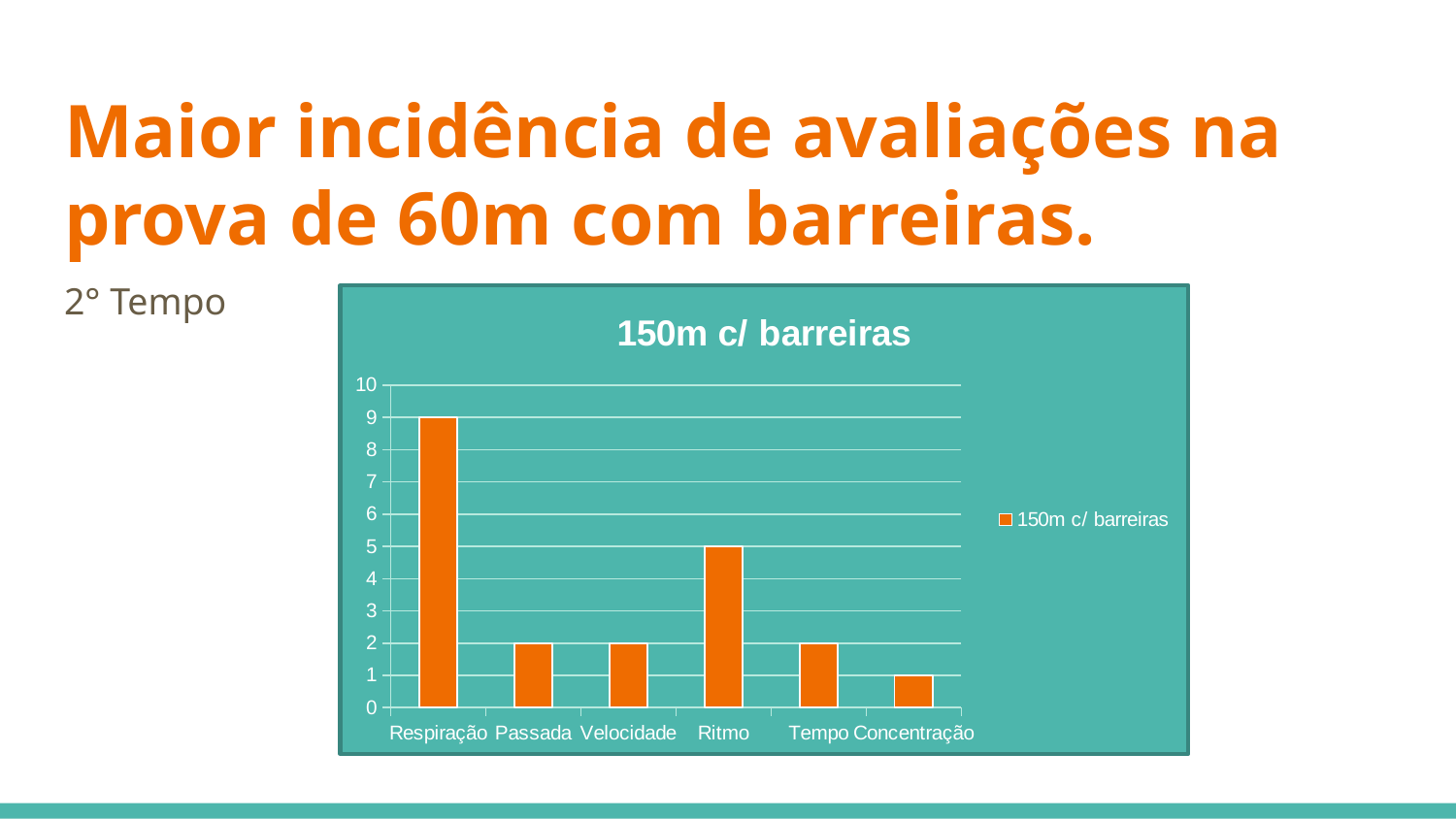
What kind of chart is shown on the slide? Bar chart Which category has the lowest value? Concentração What is the value for Concentração? 1 What is the value for Ritmo? 5 Which category has the highest value? Respiração How many categories are shown on the x axis? 6 What is the value for Passada? 2 Is the value for Respiração greater or less than 8? greater What is the title of the chart? 150m c/ barreiras What is the difference between the values for Respiração and Ritmo? 4 What is the value for Respiração? 9 Which is larger, the value for Ritmo or the value for Tempo? Ritmo